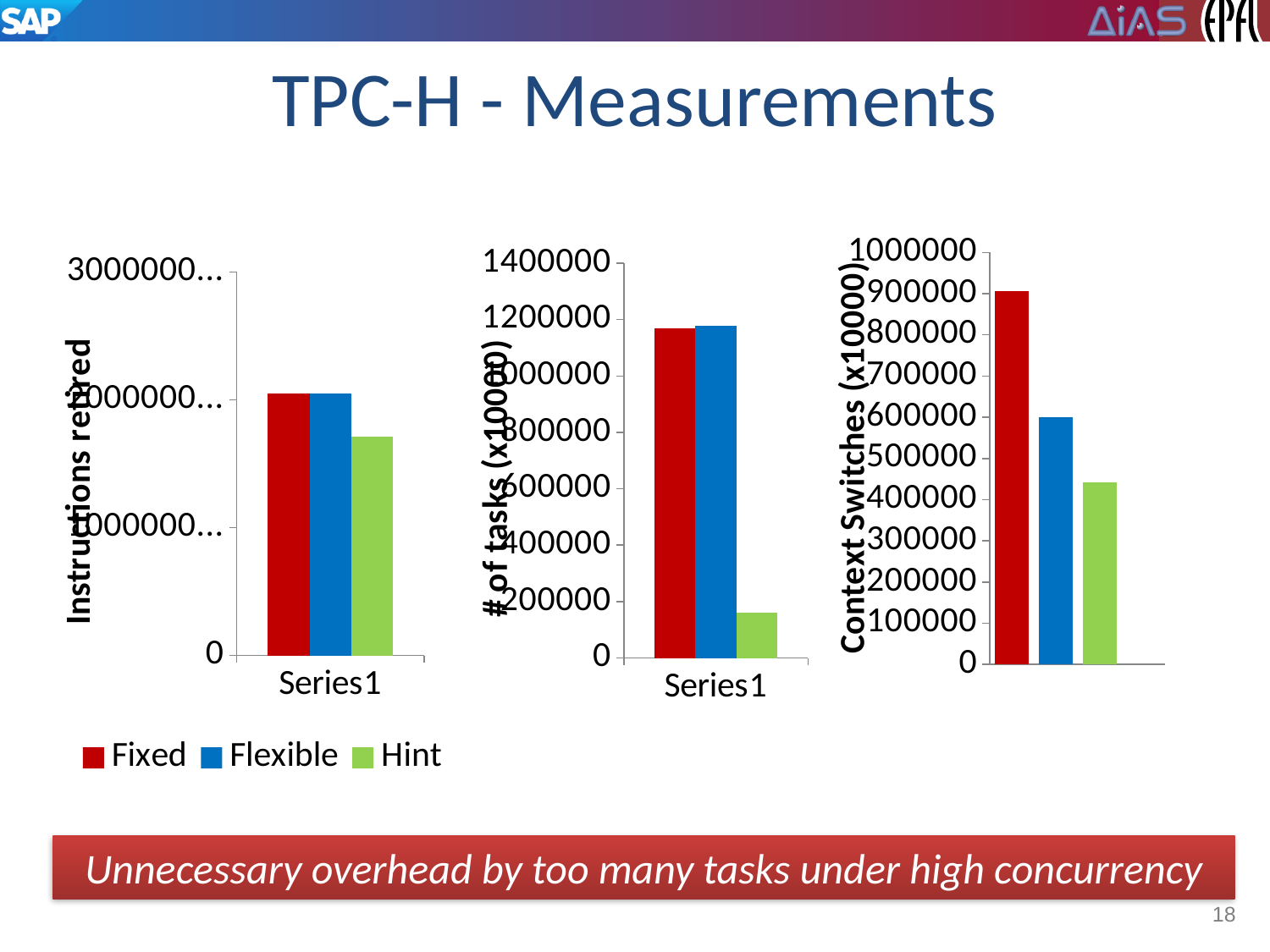
In the middle chart '# of tasks (x10000)', which series has the lowest value? Hint In the right chart 'Context Switches (x10000)', which series has the highest value? Fixed How many series does the legend list? 3 In the middle chart '# of tasks (x10000)', is the value for Fixed greater or less than 1000000? greater In the middle chart '# of tasks (x10000)', is the value for Hint greater or less than 200000? less In the left chart 'Instructions retired', which is larger, the value for Fixed or the value for Hint? Fixed What are the three series named in the legend? Fixed, Flexible, Hint In the right chart 'Context Switches (x10000)', which series has the lowest value? Hint In the right chart 'Context Switches (x10000)', is the value for Fixed greater or less than 800000? greater In the right chart 'Context Switches (x10000)', which is larger, the value for Flexible or the value for Hint? Flexible What kind of chart is the left chart titled 'Instructions retired'? bar chart